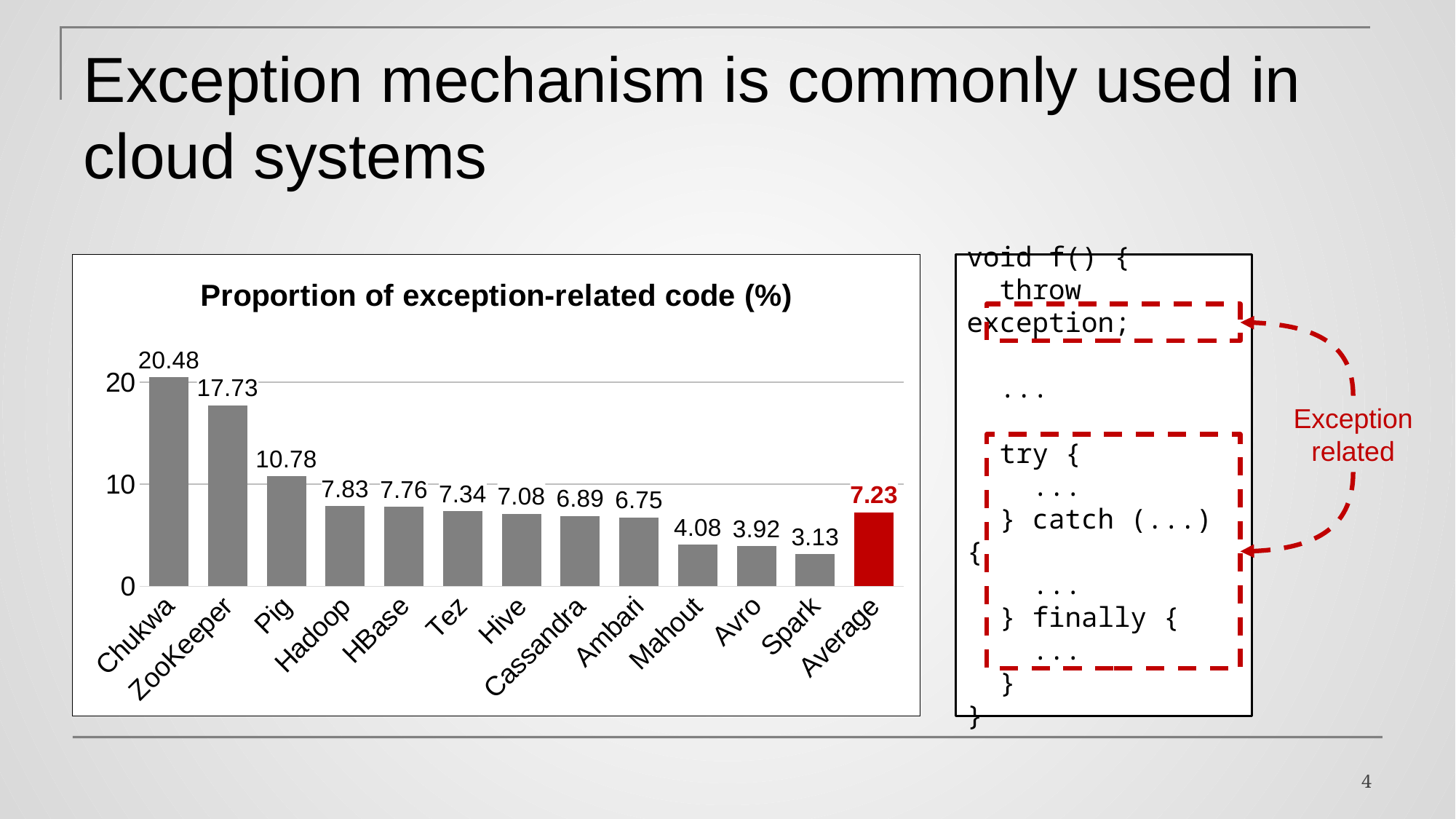
Which category has the highest value? Chukwa What is the value for Chukwa? 20.48 What is the title of the chart? Proportion of exception-related code (%) Is the value for ZooKeeper greater or less than 10? greater What is the value for Hadoop? 7.83 What kind of chart is shown on the slide? bar chart Which has a larger value, Pig or Mahout? Pig Which category has the lowest value? Spark What is the difference between the values for Chukwa and ZooKeeper? 2.75 What is the value shown for Average? 7.23 Do the values rise or fall from Chukwa to Spark along the x axis? fall How many bars are shown in the chart? 13